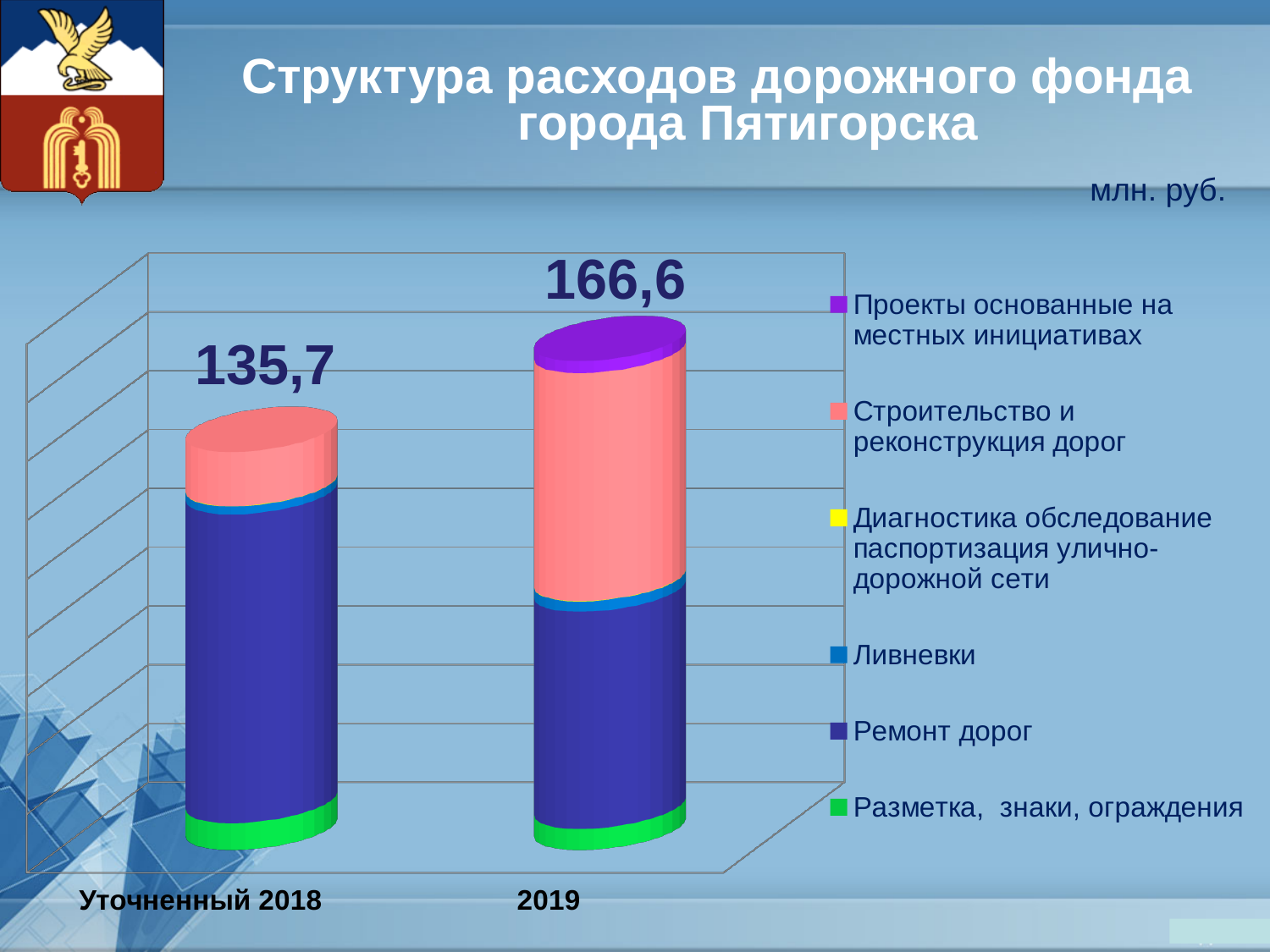
What is the difference between the 2019 total and the Уточненный 2018 total? 30,9 Is the total for 2019 larger or smaller than the total for Уточненный 2018? larger What is the total value shown for Уточненный 2018? 135,7 Do the totals rise or fall from Уточненный 2018 to 2019? rise Which category has the lower total? Уточненный 2018 Which legend entry is shown in purple? Проекты основанные на местных инициативах What unit is stated for the values on the chart? млн. руб. How many categories are shown on the x axis? 2 Which category has the higher total, Уточненный 2018 or 2019? 2019 How many series does the legend list? 6 What kind of chart is shown on the slide? stacked bar chart What is the total value shown for 2019? 166,6